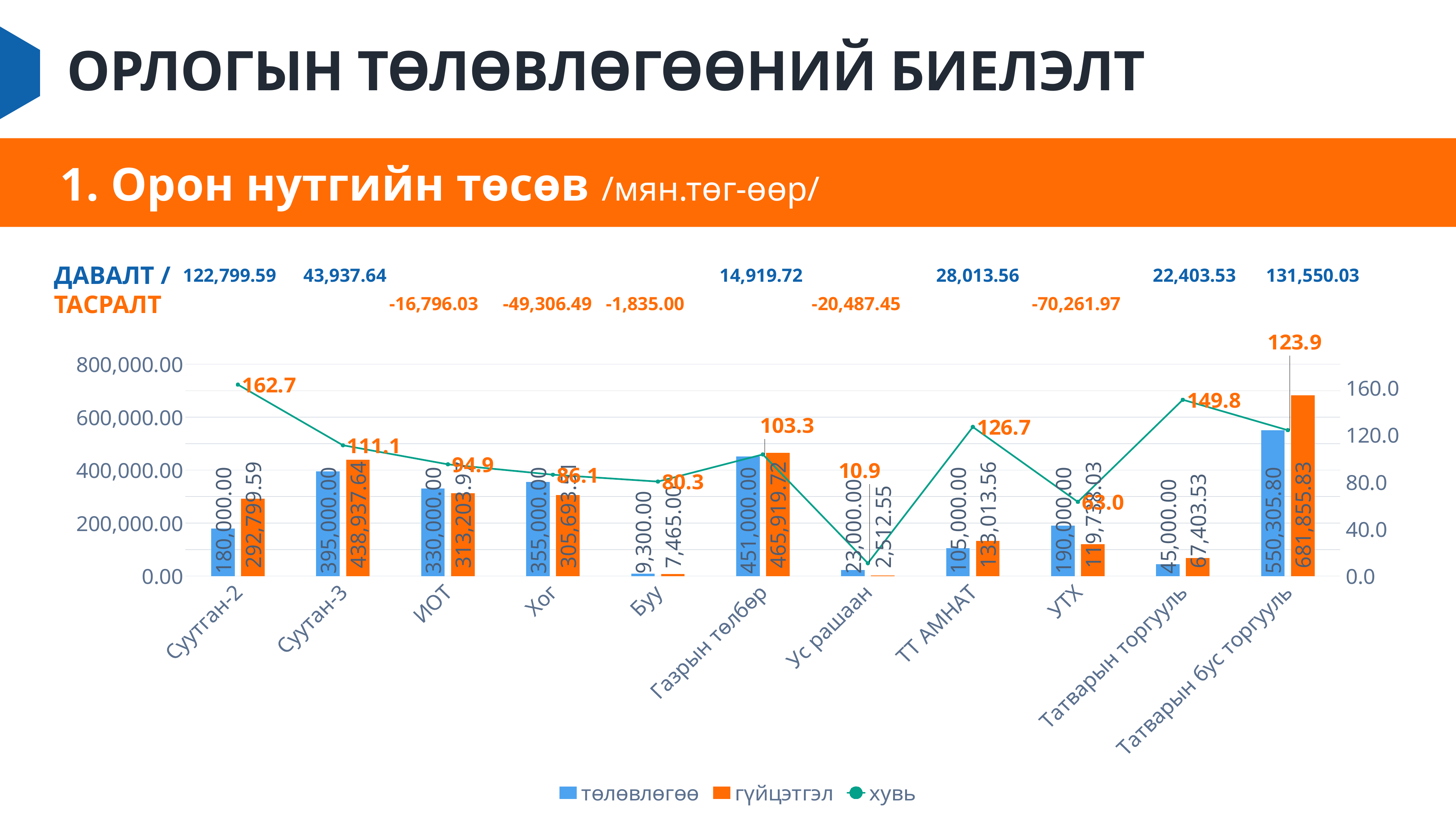
What is the difference between the actual and planned values for Татварын торгууль? 22,403.53 How many categories are shown on the x axis? 11 What is the actual value (гүйцэтгэл) for Газрын төлбөр? 465,919.72 Which category has the lowest percentage (хувь) value? Ус рашаан Which is larger for ТТ АМНАТ: the planned value or the actual value? the actual value (133,013.56) What kind of chart is this? A combined bar and line chart Which category has the highest actual value (гүйцэтгэл)? Татварын бус торгууль What is the planned value (төлөвлөгөө) for Суутган-3? 395,000.00 What is the percentage (хувь) shown for Ус рашаан? 10.9 What is the actual value (гүйцэтгэл) for Татварын бус торгууль? 681,855.83 Which category has the highest percentage (хувь) value? Суутган-2 How many series does the legend list? 3